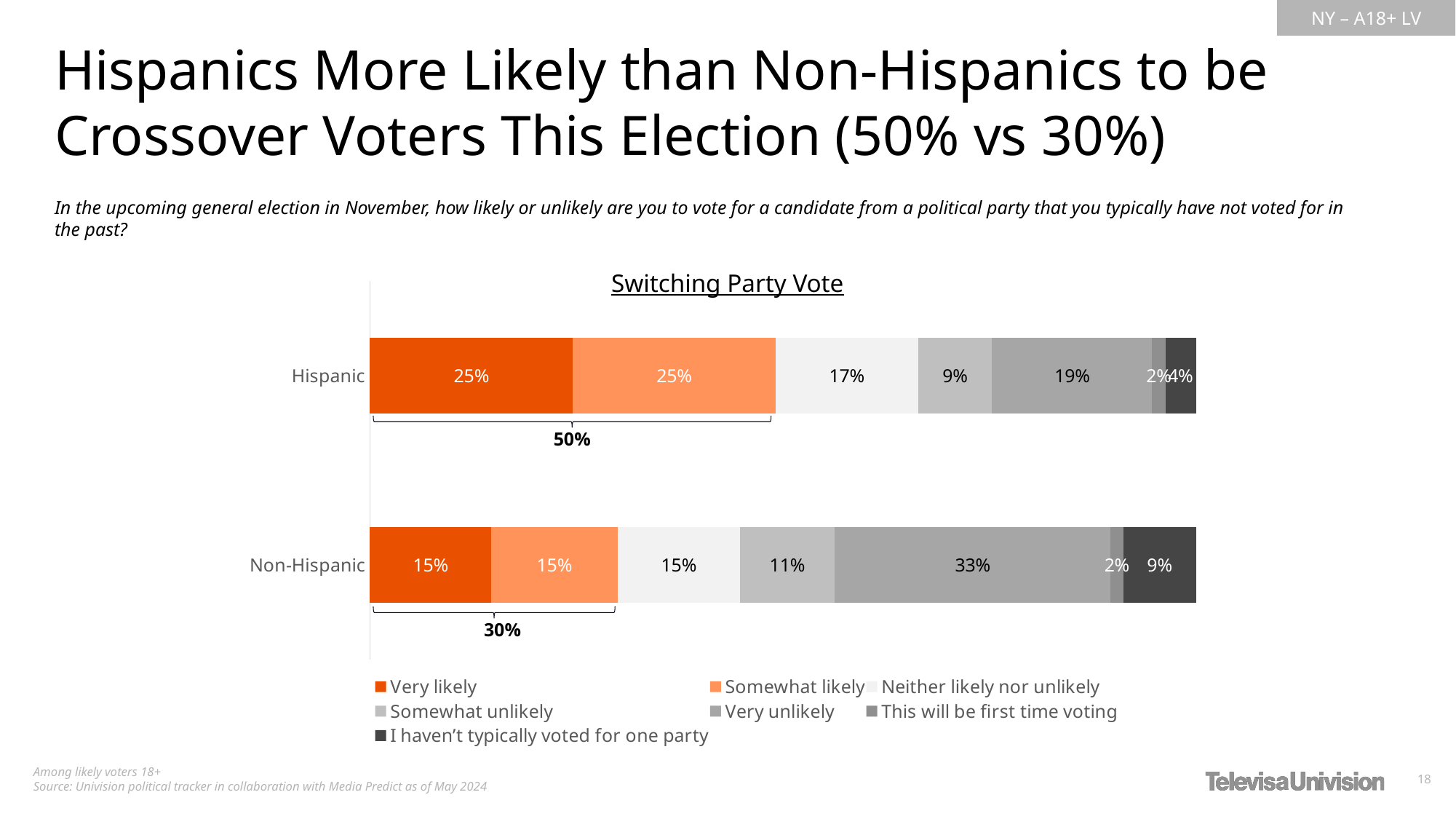
How many categories (bars) are plotted in the "Switching Party Vote" chart? 2 What is the "Somewhat unlikely" value for Hispanic respondents? 9% Which group has the larger "Neither likely nor unlikely" value, Hispanic or Non-Hispanic? Hispanic How many series does the legend of the "Switching Party Vote" chart list? 7 What kind of chart is shown under the title "Switching Party Vote"? Stacked bar chart What combined share of Non-Hispanic respondents is shown by the bracket covering "Very likely" and "Somewhat likely"? 30% What is the difference between the "Very unlikely" values for Non-Hispanic and Hispanic respondents? 14 percentage points Which segment is the largest in the Non-Hispanic bar? Very unlikely What is the "Very unlikely" value for Non-Hispanic respondents? 33% What is the "I haven't typically voted for one party" value for Non-Hispanic respondents? 9% What is the "Very likely" value for Hispanic respondents? 25% What combined share of Hispanic respondents is shown by the bracket covering "Very likely" and "Somewhat likely"? 50%